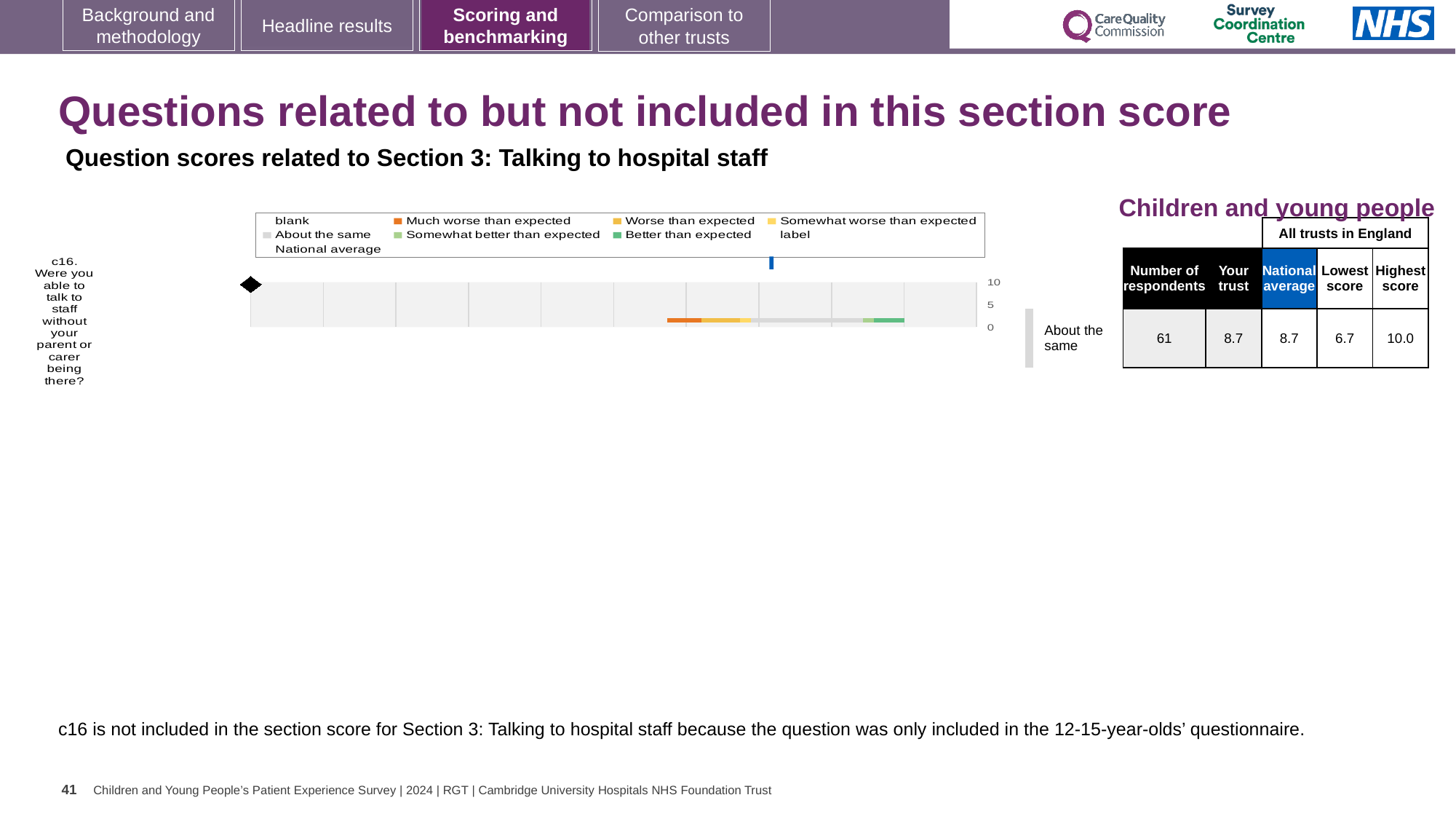
What is the trust's score for c16 shown in the table beside the chart? 8.7 What is the difference between the highest and lowest scores for c16 across all trusts in England? 3.3 What is the highest score across all trusts in England for c16? 10.0 What kind of chart is used to show the c16 question score? bar chart Which question is plotted on the chart? c16. Were you able to talk to staff without your parent or carer being there? What is the lowest score across all trusts in England for c16? 6.7 What category is the trust's result for c16 placed in, according to the label next to the chart? About the same What is the highest value shown on the chart's numeric axis? 10 How many respondents answered c16 for this trust? 61 What is the national average score for c16 shown in the table beside the chart? 8.7 How many questions are plotted on the chart? 1 Is the trust's score for c16 larger than, smaller than, or equal to the national average? equal